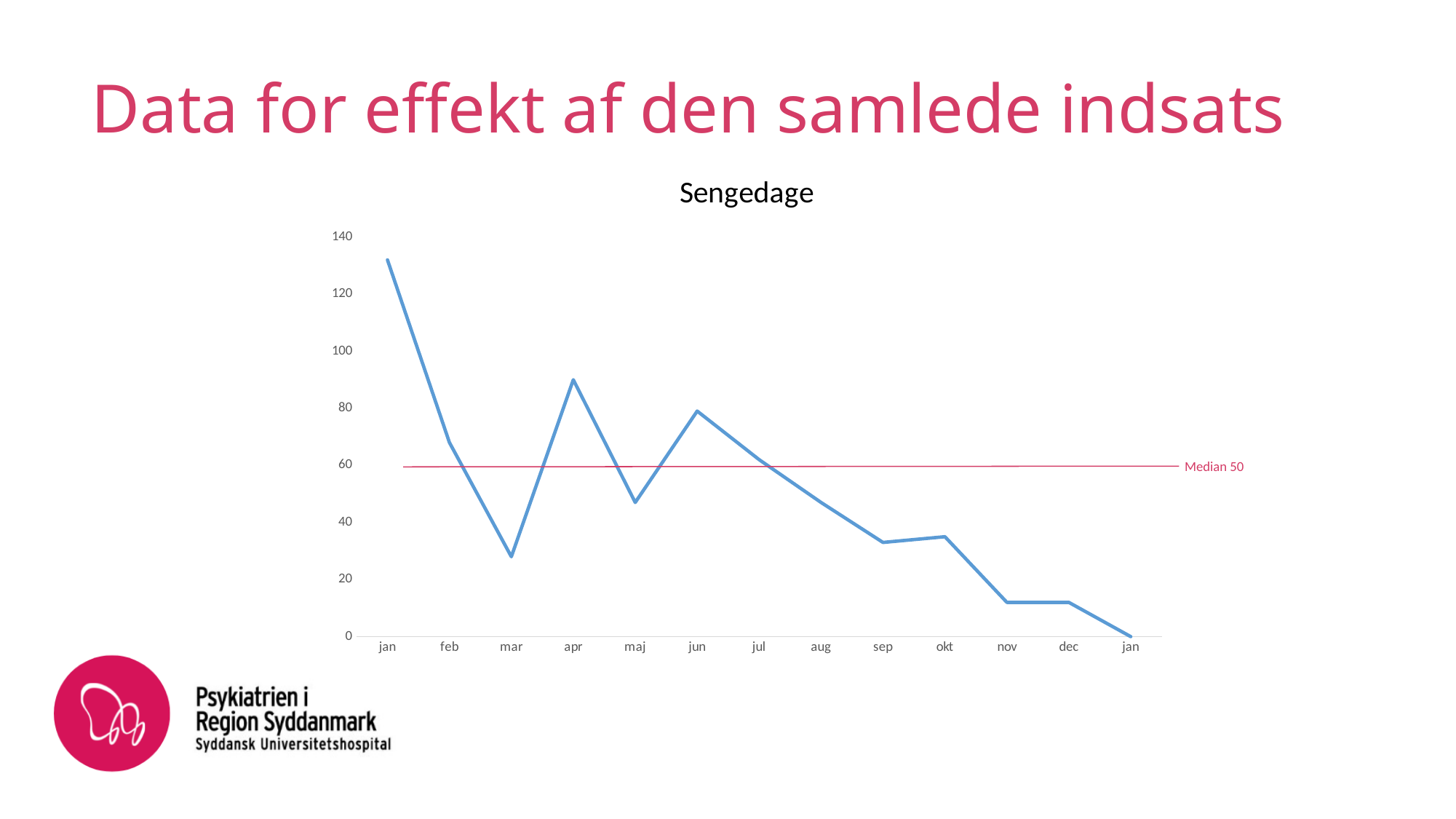
What is the value for the final jan point? 0 What is the title of the chart? Sengedage Which month has the lowest value? jan (the last one) Which is larger, the value for apr or the value for jun? apr What kind of chart is shown on the slide? line chart Which month has the highest value? jan (the first one) What is the label on the horizontal reference line? Median 50 Is the value for the first jan greater or less than 120? greater How many data points are plotted on the line? 13 Is the value for mar greater or less than 40? less Is the value for apr greater or less than 80? greater Do the values generally rise or fall from the first jan to the last jan? fall